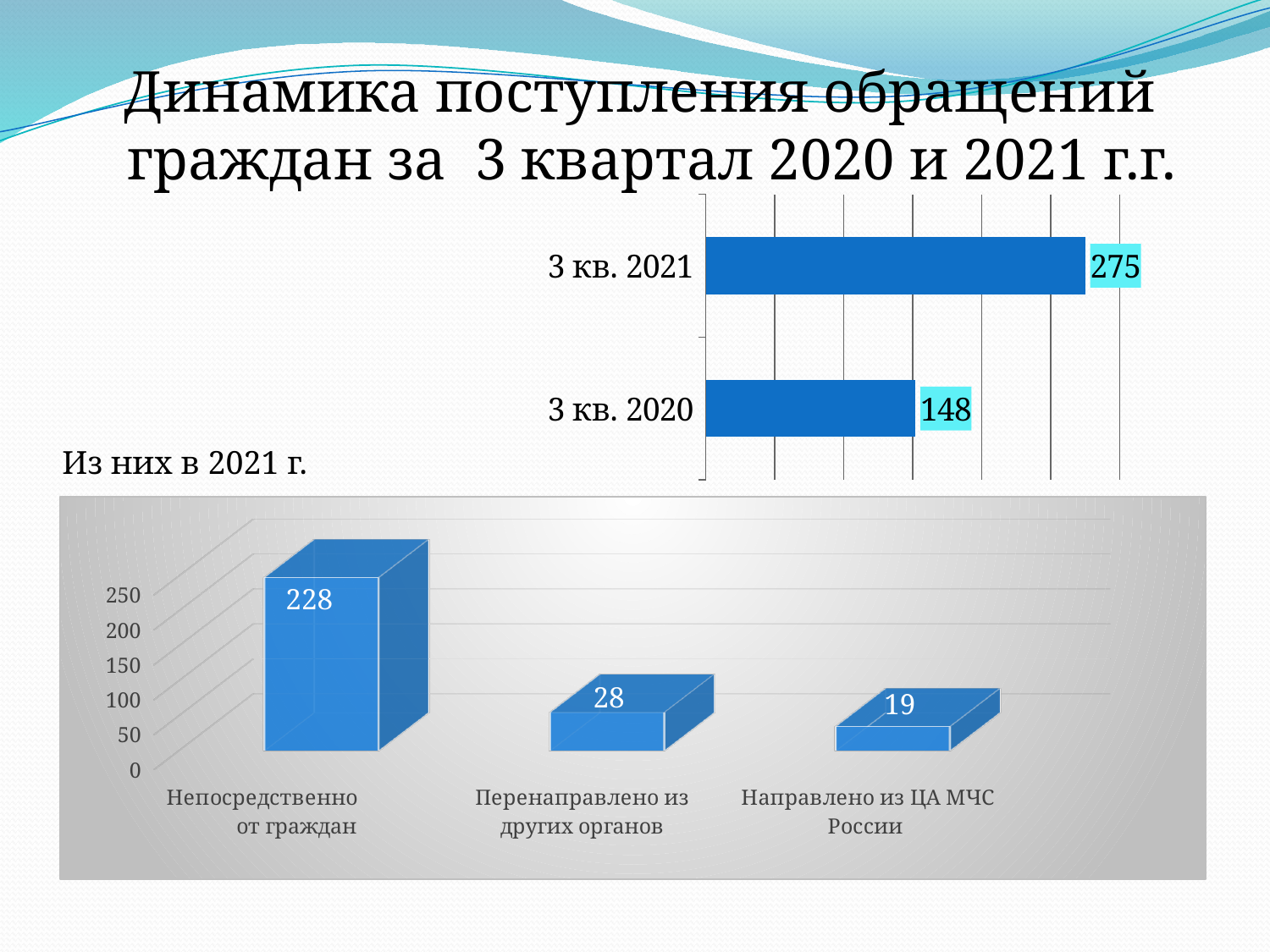
In the top chart, what is the value for 3 кв. 2020? 148 In the top chart, which period has the higher value, 3 кв. 2021 or 3 кв. 2020? 3 кв. 2021 In the bottom chart, which category has the lowest value? Направлено из ЦА МЧС России In the bottom chart, what is the difference between Непосредственно от граждан and Перенаправлено из других органов? 200 What kind of chart is the top chart? Bar chart In the top chart, how many bars are plotted? 2 In the top chart, what is the difference between the values for 3 кв. 2021 and 3 кв. 2020? 127 In the bottom chart, what is the value for Направлено из ЦА МЧС России? 19 In the bottom chart, what is the value for Перенаправлено из других органов? 28 In the bottom chart, how many categories are shown? 3 In the bottom chart, what is the value for Непосредственно от граждан? 228 In the top chart, what is the value for 3 кв. 2021? 275